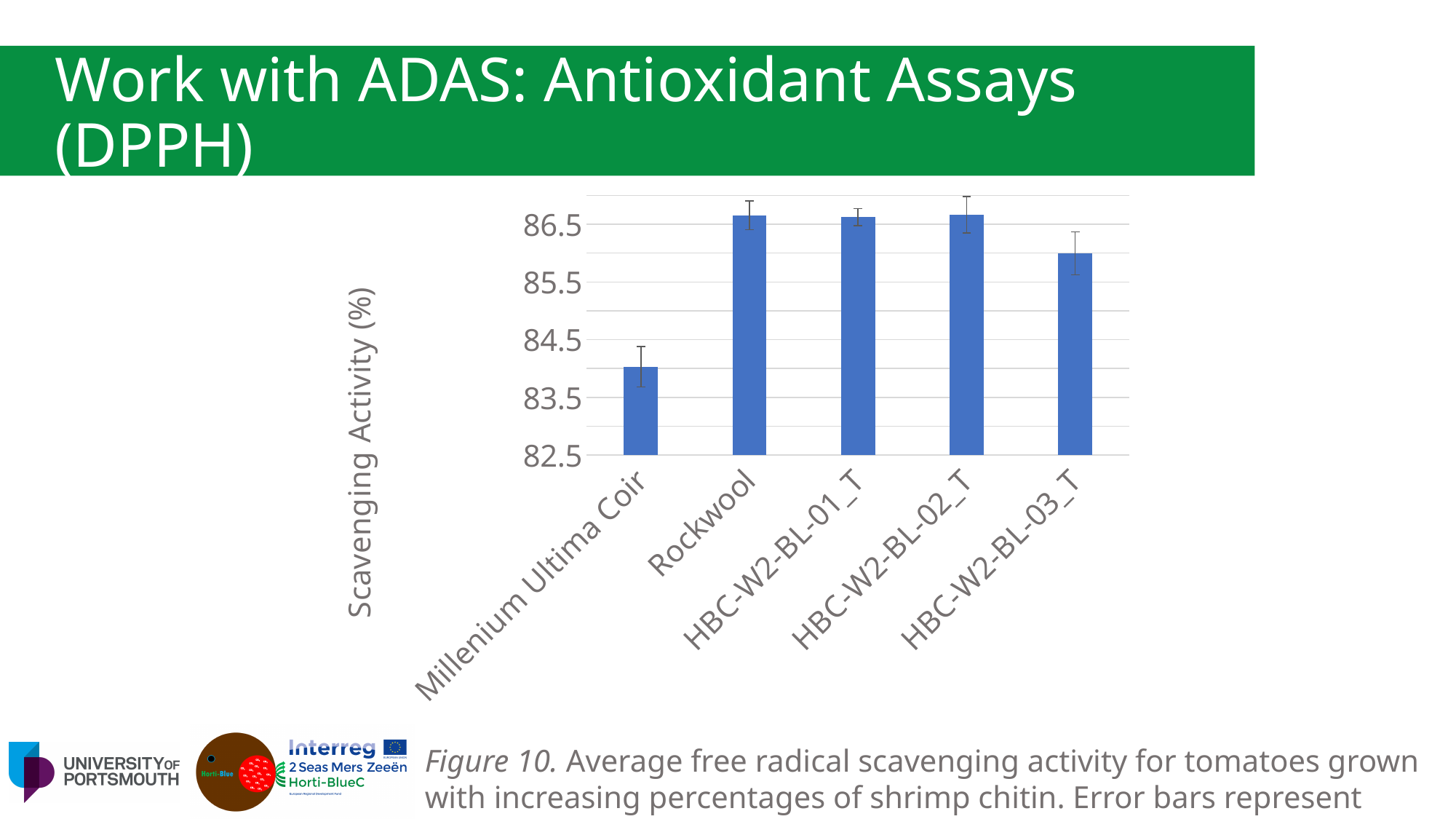
Which has a higher scavenging activity, Rockwool or HBC-W2-BL-03_T? Rockwool How many categories are plotted on the x axis of the chart? 5 Which has a lower scavenging activity, HBC-W2-BL-02_T or HBC-W2-BL-03_T? HBC-W2-BL-03_T Is the value for HBC-W2-BL-01_T greater or less than 85.5? greater What kind of chart is shown on the slide? bar chart Is the value for HBC-W2-BL-03_T greater or less than 86.5? less Is the value for HBC-W2-BL-03_T greater or less than 85.5? greater Which has a higher scavenging activity, Millenium Ultima Coir or Rockwool? Rockwool Which category has the lowest scavenging activity? Millenium Ultima Coir What is the label on the y axis of the chart? Scavenging Activity (%)